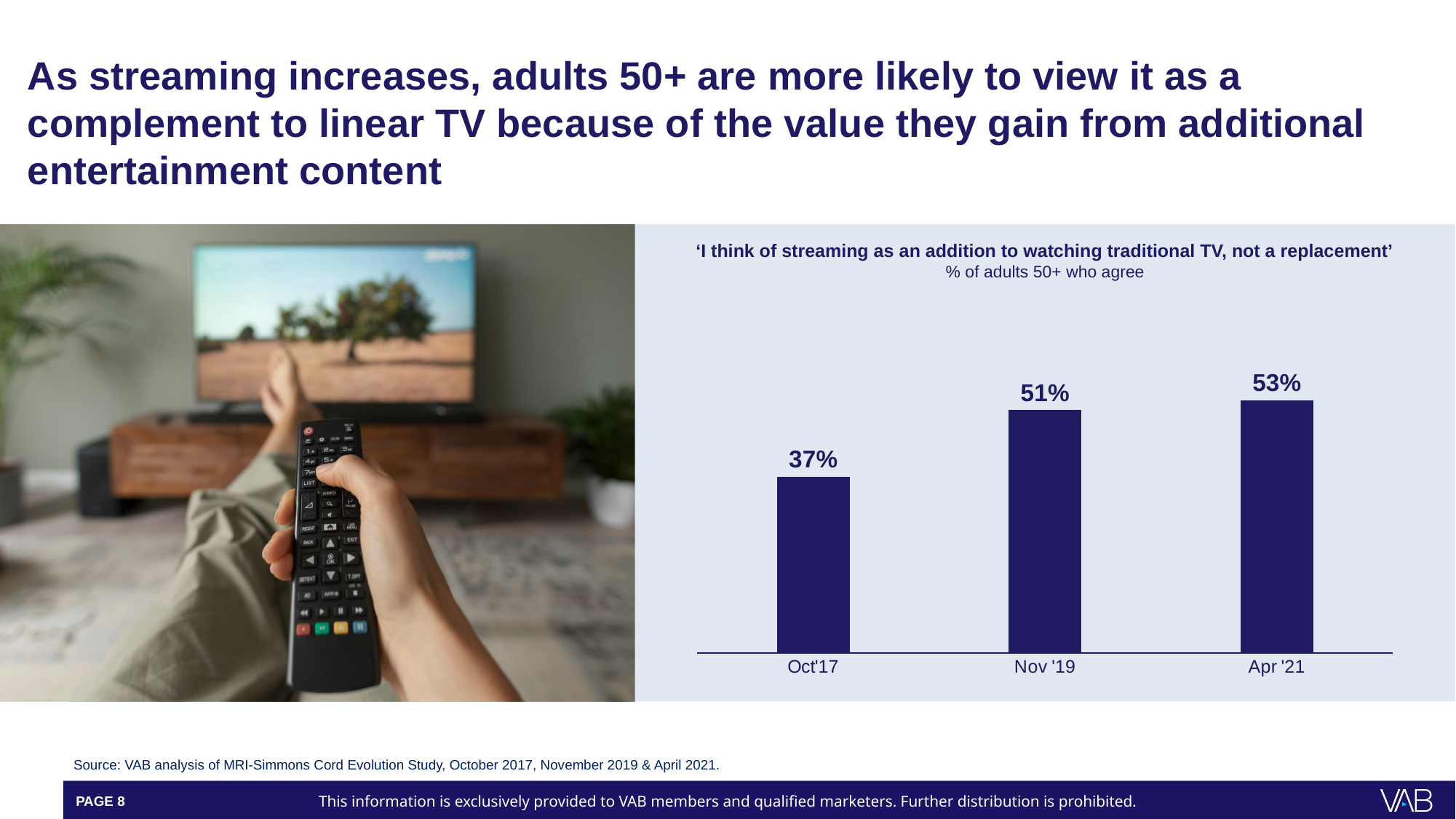
By how many percentage points did agreement increase from Oct'17 to Apr '21? 16 percentage points How many time periods are shown in the chart? 3 Which period has the highest percentage of adults 50+ who agree? Apr '21 What statement were adults 50+ asked whether they agree with in the chart? 'I think of streaming as an addition to watching traditional TV, not a replacement' By how many percentage points did agreement increase from Nov '19 to Apr '21? 2 percentage points Do the values rise or fall from Oct'17 to Apr '21? Rise Which is larger, the value for Oct'17 or the value for Nov '19? Nov '19 What percentage of adults 50+ agreed with the statement in Oct'17? 37% What percentage of adults 50+ agreed with the statement in Nov '19? 51% What percentage of adults 50+ agreed with the statement in Apr '21? 53% What type of chart is shown on the slide? Bar chart Which period has the lowest percentage of adults 50+ who agree? Oct'17